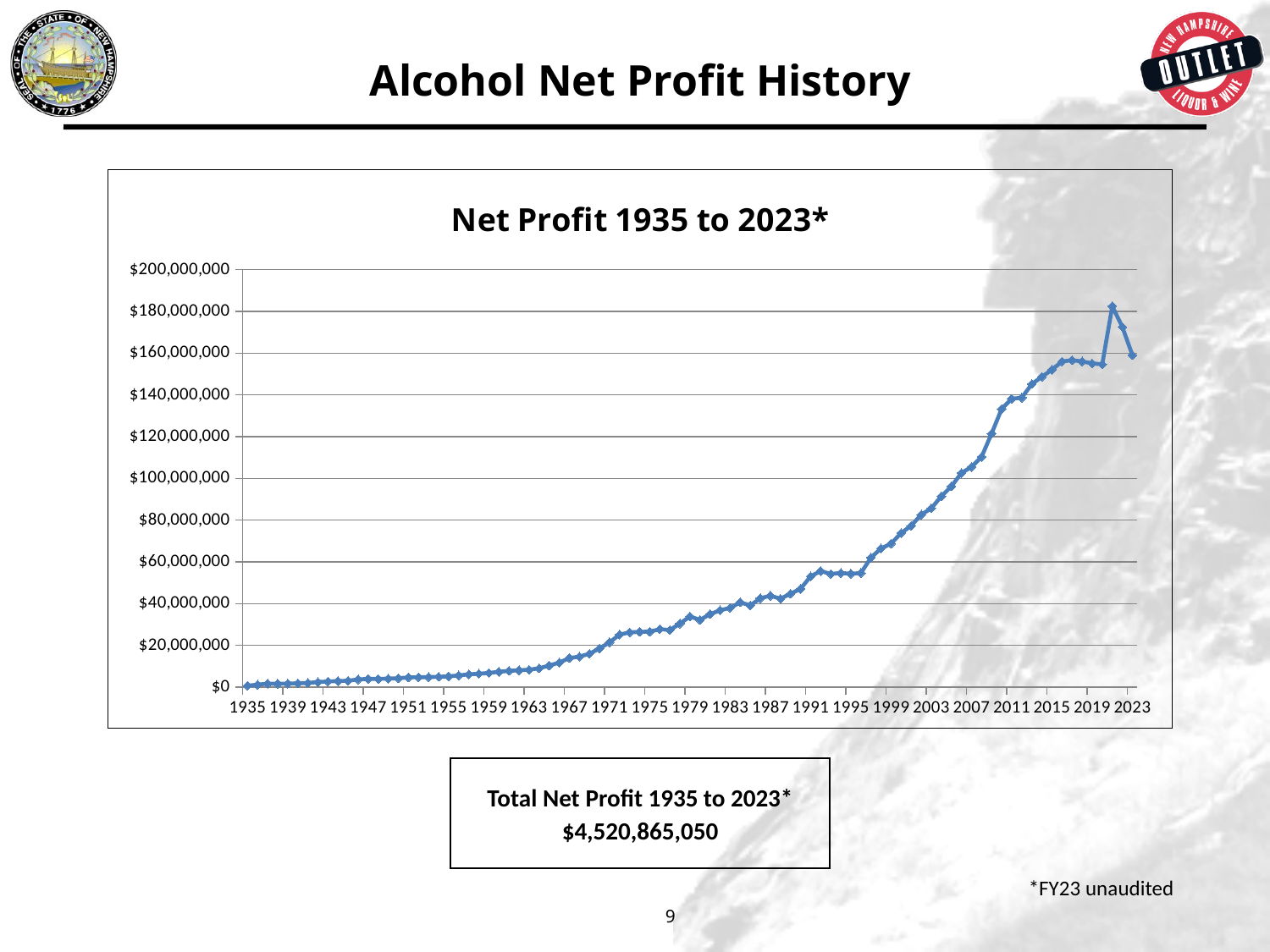
Is the net profit value for 2021 greater or less than $160,000,000? greater Is the net profit value for 2023 greater or less than $140,000,000? greater Is the net profit value for 2003 greater or less than $100,000,000? less In which year does the net profit line reach its highest point? 2021 Overall, do net profit values rise or fall from 1935 to 2023 along the x axis? rise What total net profit for 1935 to 2023 is stated in the box below the chart? $4,520,865,050 What kind of chart is shown on the slide? line chart Which year has the larger net profit, 1995 or 2015? 2015 What is the title of the chart? Net Profit 1935 to 2023*